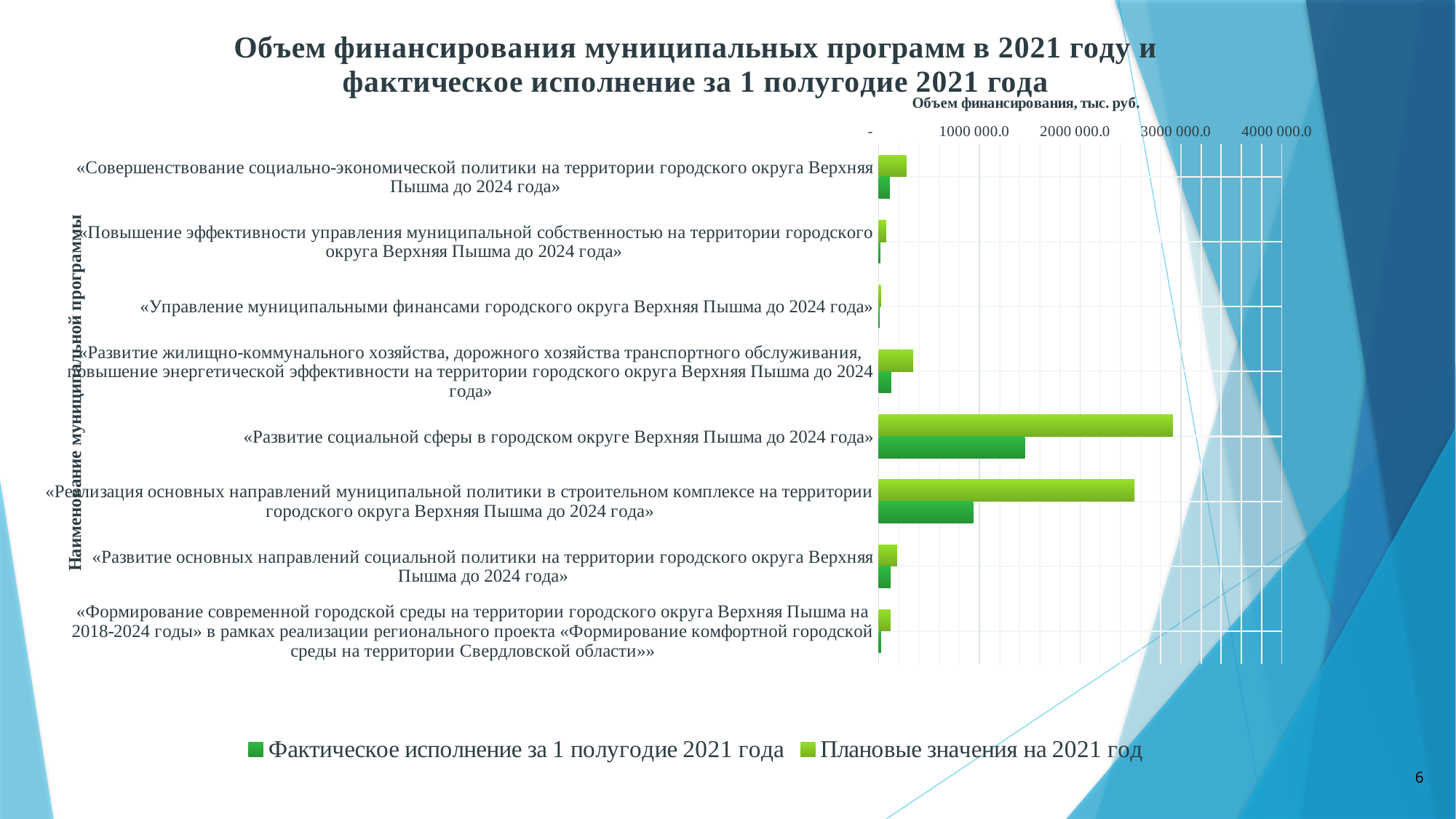
Which has the larger planned 2021 value: «Развитие социальной сферы в городском округе Верхняя Пышма до 2024 года» or «Реализация основных направлений муниципальной политики в строительном комплексе на территории городского округа Верхняя Пышма до 2024 года»? «Развитие социальной сферы в городском округе Верхняя Пышма до 2024 года» Is the planned 2021 value for «Развитие социальной сферы в городском округе Верхняя Пышма до 2024 года» greater or less than 2000 000.0? greater How many municipal programmes (categories) are plotted on the chart? 8 For «Развитие социальной сферы в городском округе Верхняя Пышма до 2024 года», which is larger: the planned 2021 value or the actual execution for the 1st half of 2021? Planned 2021 value Is the planned 2021 value for «Развитие жилищно-коммунального хозяйства, дорожного хозяйства транспортного обслуживания, повышение энергетической эффективности на территории городского округа Верхняя Пышма до 2024 года» greater or less than 1000 000.0? less Which programme has the highest planned value for 2021 (Плановые значения на 2021 год)? «Развитие социальной сферы в городском округе Верхняя Пышма до 2024 года» Which programme has the highest actual execution for the 1st half of 2021 (Фактическое исполнение за 1 полугодие 2021 года)? «Развитие социальной сферы в городском округе Верхняя Пышма до 2024 года» What is the title of the value axis of the chart? Объем финансирования, тыс. руб. What kind of chart is shown on the slide? Bar chart Is the planned 2021 value for «Реализация основных направлений муниципальной политики в строительном комплексе на территории городского округа Верхняя Пышма до 2024 года» greater or less than 2000 000.0? greater How many series does the chart legend list? 2